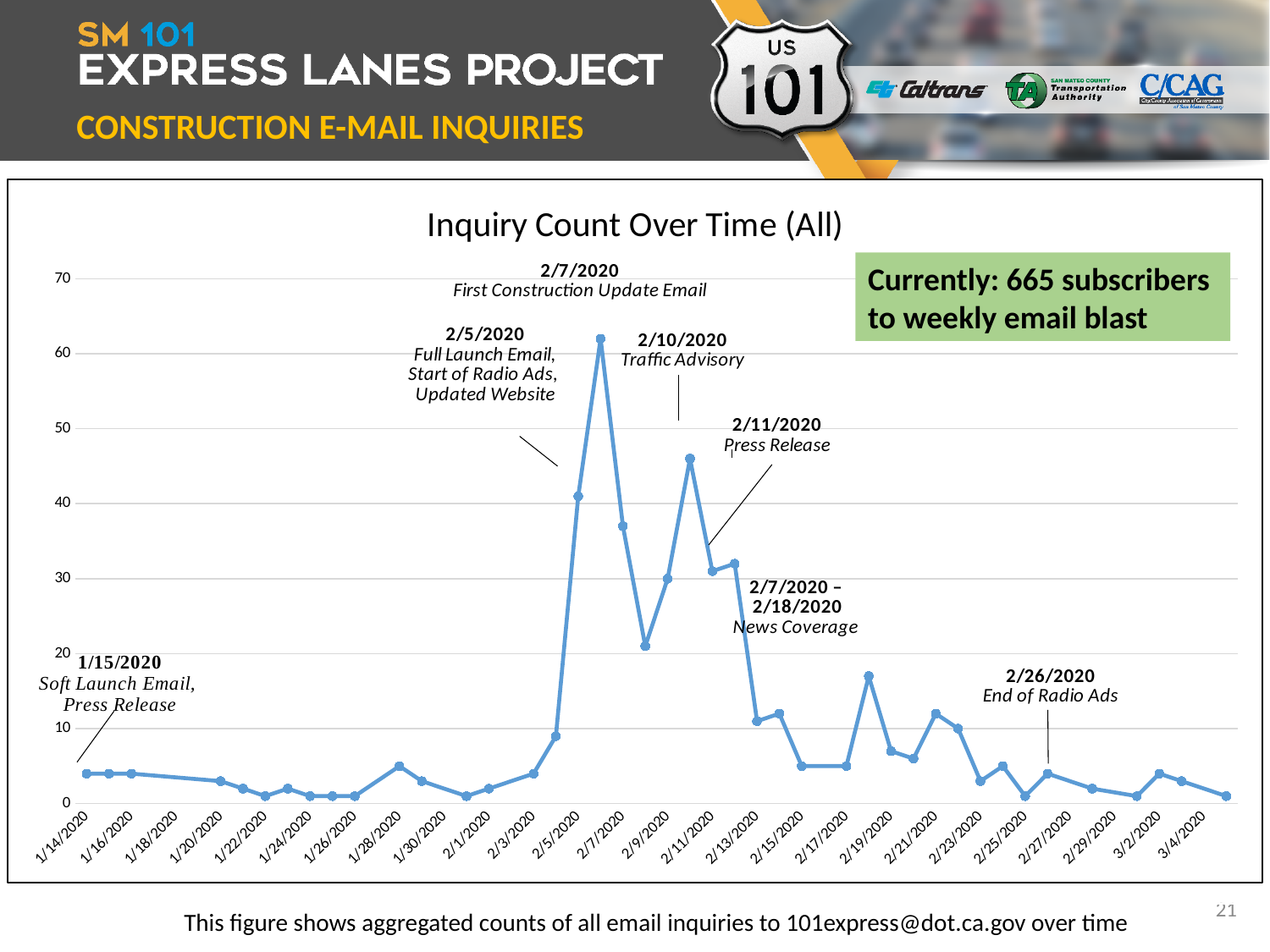
What is the title of the chart? Inquiry Count Over Time (All) Which date has the higher inquiry count, 2/7/2020 or 2/11/2020? 2/7/2020 Is the inquiry count on 2/19/2020 greater or less than 10? less Which date has the higher inquiry count, 2/15/2020 or 2/19/2020? 2/19/2020 Is the inquiry count on 2/11/2020 greater or less than 40? less What event does the chart annotation give for 2/26/2020? End of Radio Ads What kind of chart is shown on the slide? line chart Is the inquiry count on 1/14/2020 greater or less than 10? less Does the inquiry count rise or fall between 2/7/2020 and 2/9/2020? fall On which date does the inquiry count reach its highest point? 2/6/2020